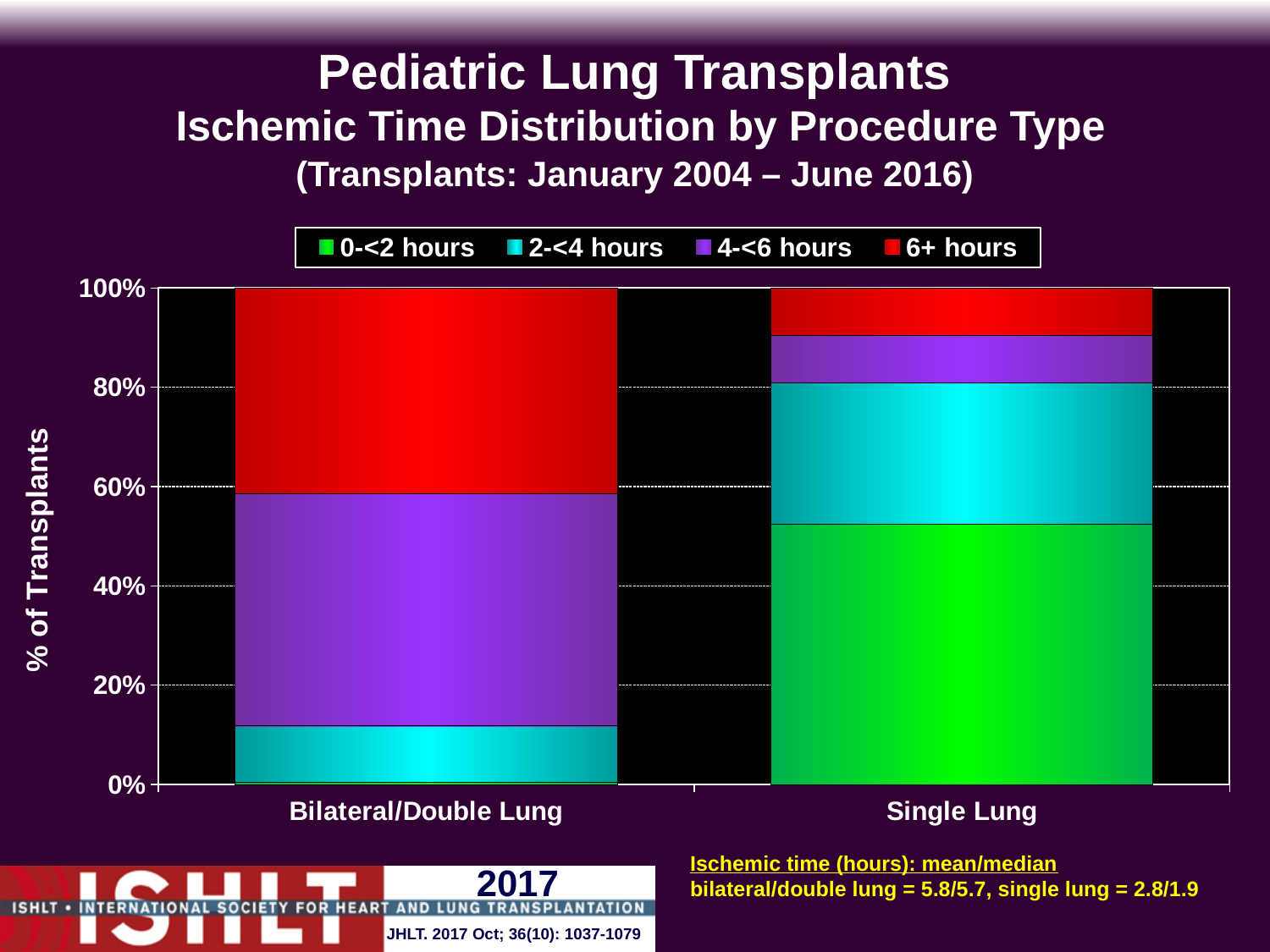
Which procedure type has the larger 6+ hours share, Bilateral/Double Lung or Single Lung? Bilateral/Double Lung Which ischemic time series is shown in red in the legend? 6+ hours Is the 2-<4 hours share for Bilateral/Double Lung greater or less than 20%? less How many series does the legend list? 4 How many procedure type categories are shown on the x axis? 2 Is the 6+ hours share for Single Lung greater or less than 20%? less Is the 2-<4 hours share for Single Lung greater or less than 20%? greater What is the total height of the Single Lung stacked bar? 100% Which procedure type has the larger 0-<2 hours share, Bilateral/Double Lung or Single Lung? Single Lung What is the label of the y axis? % of Transplants What kind of chart is shown on the slide? Stacked bar chart